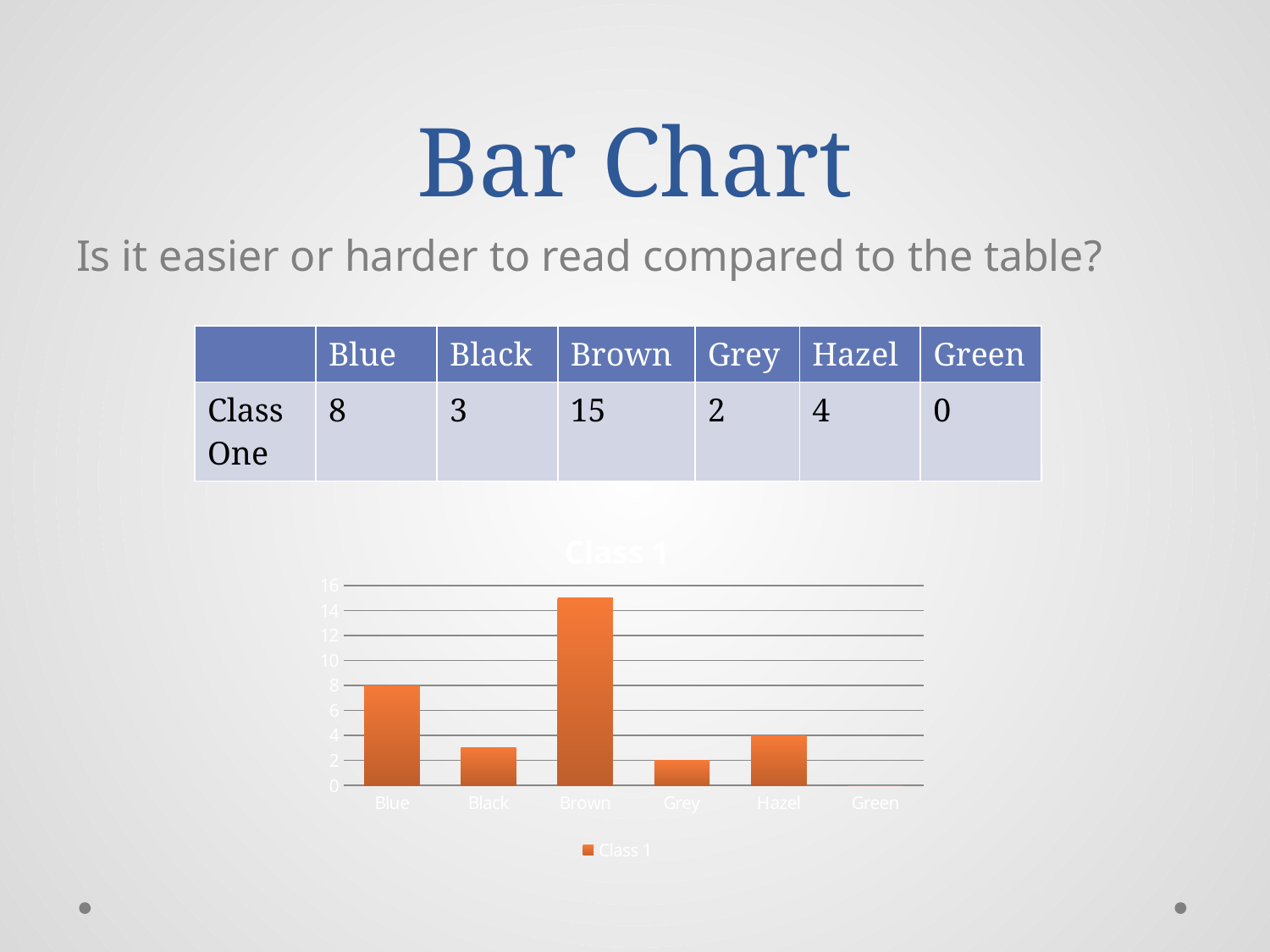
What is the value for Hazel in the bar chart? 4 What kind of chart is shown on the slide? bar chart What is the value for Brown in the bar chart? 15 How many series does the chart legend list? 1 Which category has the lowest value in the chart? Green Which category has the highest bar in the chart? Brown What is the difference between the values for Brown and Blue? 7 How many categories are shown on the x axis of the chart? 6 Which is larger in the chart, the value for Black or the value for Hazel? Hazel Is the value for Brown greater or less than 10? greater What is the value for Blue in the bar chart? 8 What is the value for Grey in the bar chart? 2